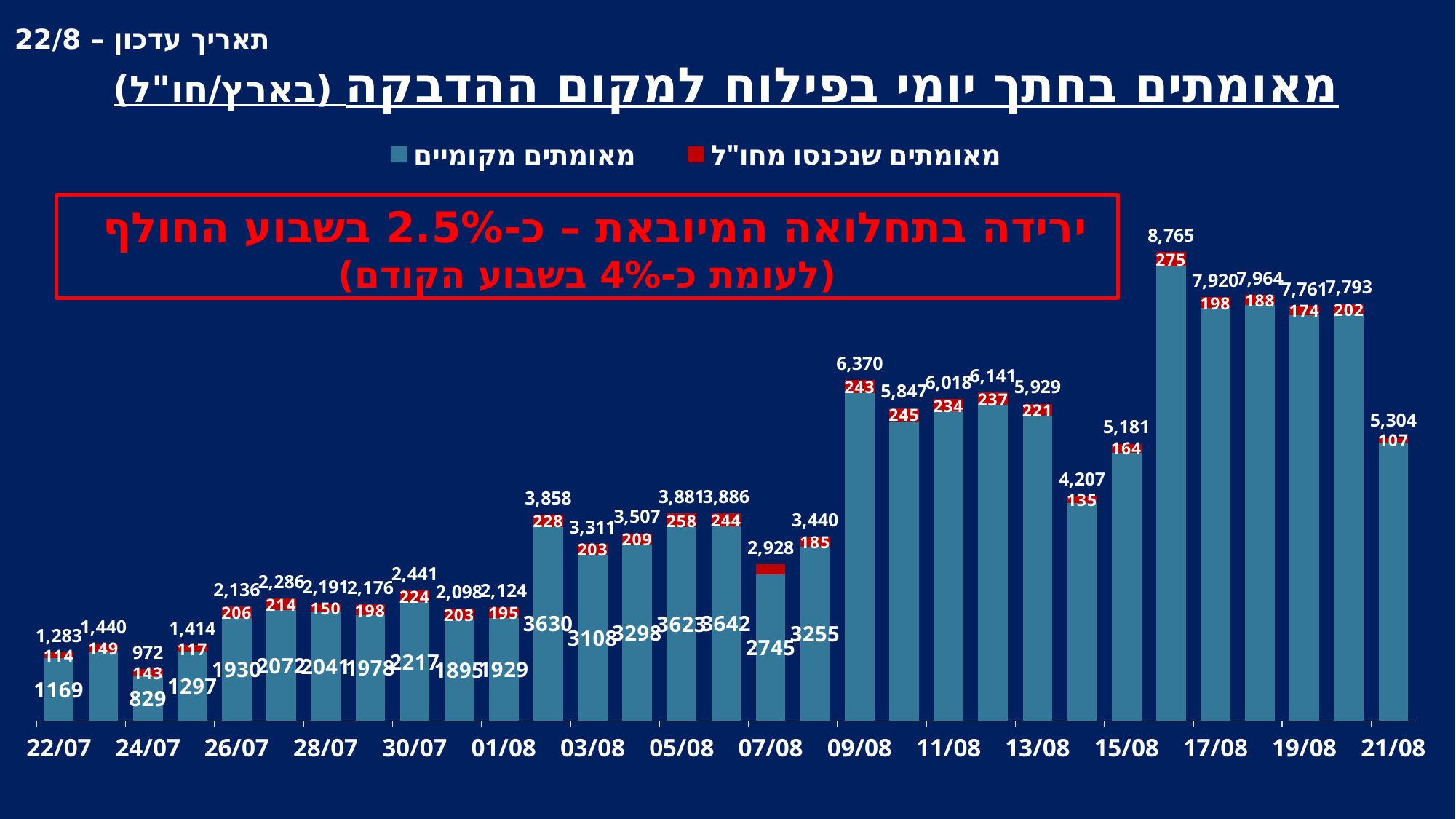
Which date has the larger total, 13/08 or 15/08? 13/08 What is the value for local confirmed cases (מאומתים מקומיים) on 22/07? 1169 What is the total value shown for 17/08? 7,920 Which colour represents confirmed cases entering from abroad (מאומתים שנכנסו מחו"ל) in the legend? Red Which date has the lowest daily total in the chart? 24/07 How many series does the legend list? 2 How many daily bars are plotted in the chart? 31 What is the highest daily total shown in the chart? 8,765 What is the total value shown for 09/08? 6,370 What is the difference between the total for 09/08 and the total for 07/08? 3,442 What kind of chart is shown on the slide? Stacked bar chart What is the value for confirmed cases entering from abroad (מאומתים שנכנסו מחו"ל) on 21/08? 107